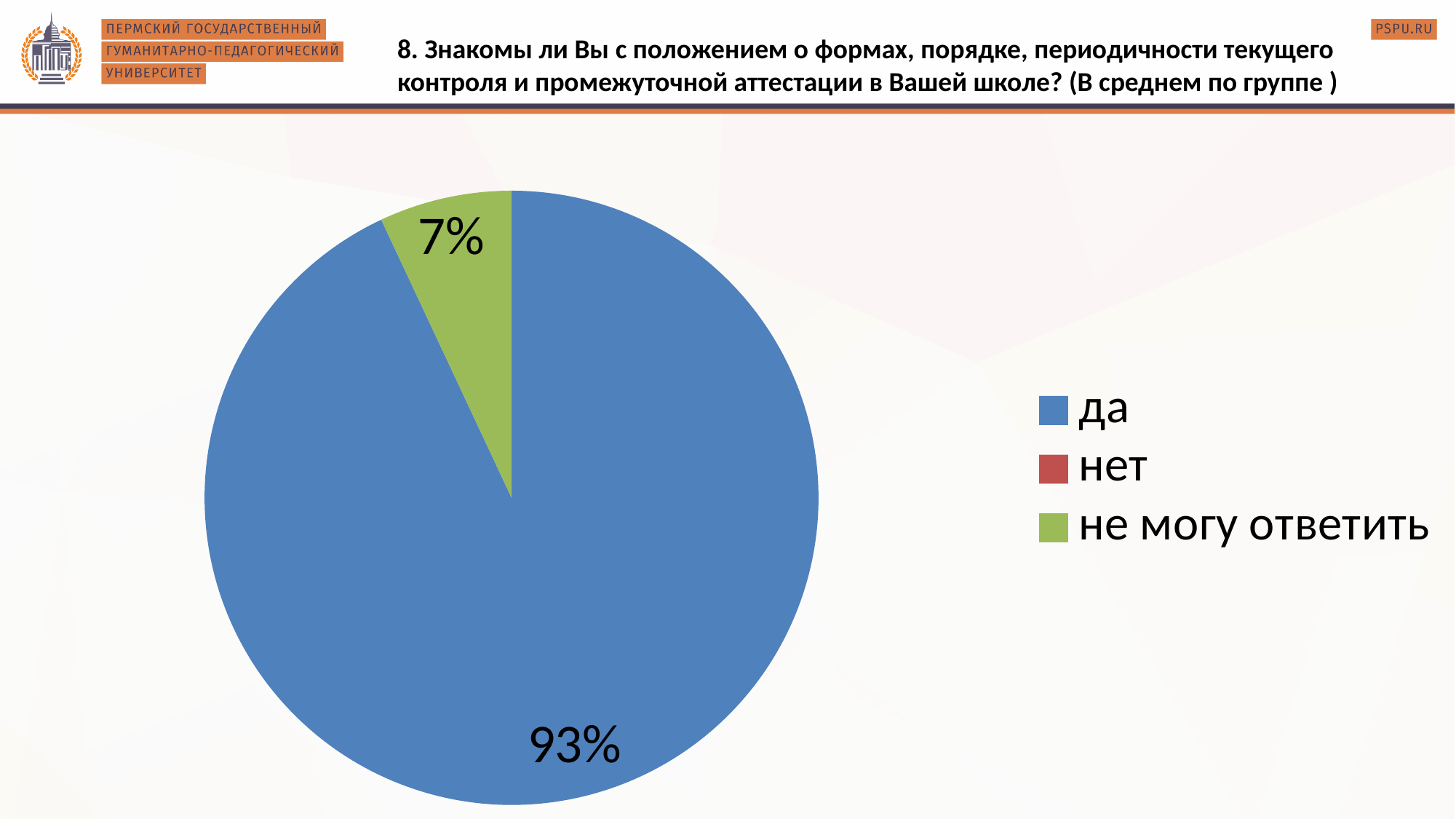
What is the value printed on the green slice? 7% Which category has the largest slice of the pie? да Which of the two labelled slices is larger, "да" or "не могу ответить"? да What is the difference in percentage points between the "да" slice and the "не могу ответить" slice? 86 How many entries does the legend list? 3 Which legend entry is shown in green? не могу ответить What share of the pie does "не могу ответить" take? 7% What share of the pie does "да" take? 93% Which legend entry is shown in blue? да What is the value printed on the blue slice? 93% What type of chart is shown on the slide? pie chart